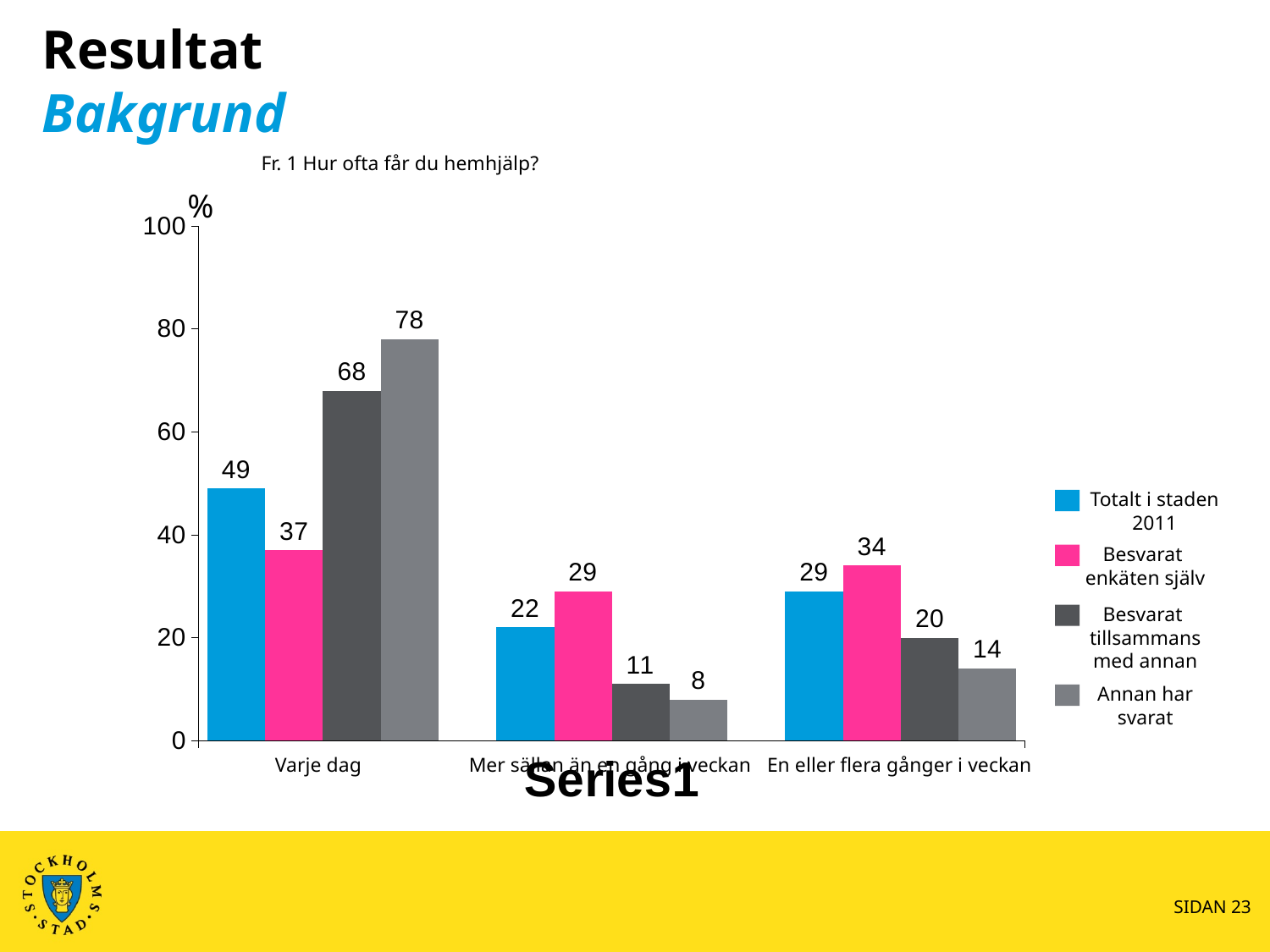
What is the difference between "Annan har svarat" and "Besvarat tillsammans med annan" in the "Varje dag" category? 10 Which series has the lowest value in the "Mer sällan än en gång i veckan" category? Annan har svarat What is the title of the chart? Fr. 1 Hur ofta får du hemhjälp? How many categories are shown on the x axis? 3 In the "En eller flera gånger i veckan" category, which is larger: "Totalt i staden 2011" or "Besvarat enkäten själv"? Besvarat enkäten själv What is the value for "Annan har svarat" in the "Varje dag" category? 78 Which series has the highest value in the "Varje dag" category? Annan har svarat What is the value for "Totalt i staden 2011" in the "Varje dag" category? 49 Is the value for "Besvarat tillsammans med annan" in the "Varje dag" category greater or less than 60? greater How many series does the legend list? 4 What is the value for "Besvarat enkäten själv" in the "En eller flera gånger i veckan" category? 34 What kind of chart is shown on the slide? Bar chart